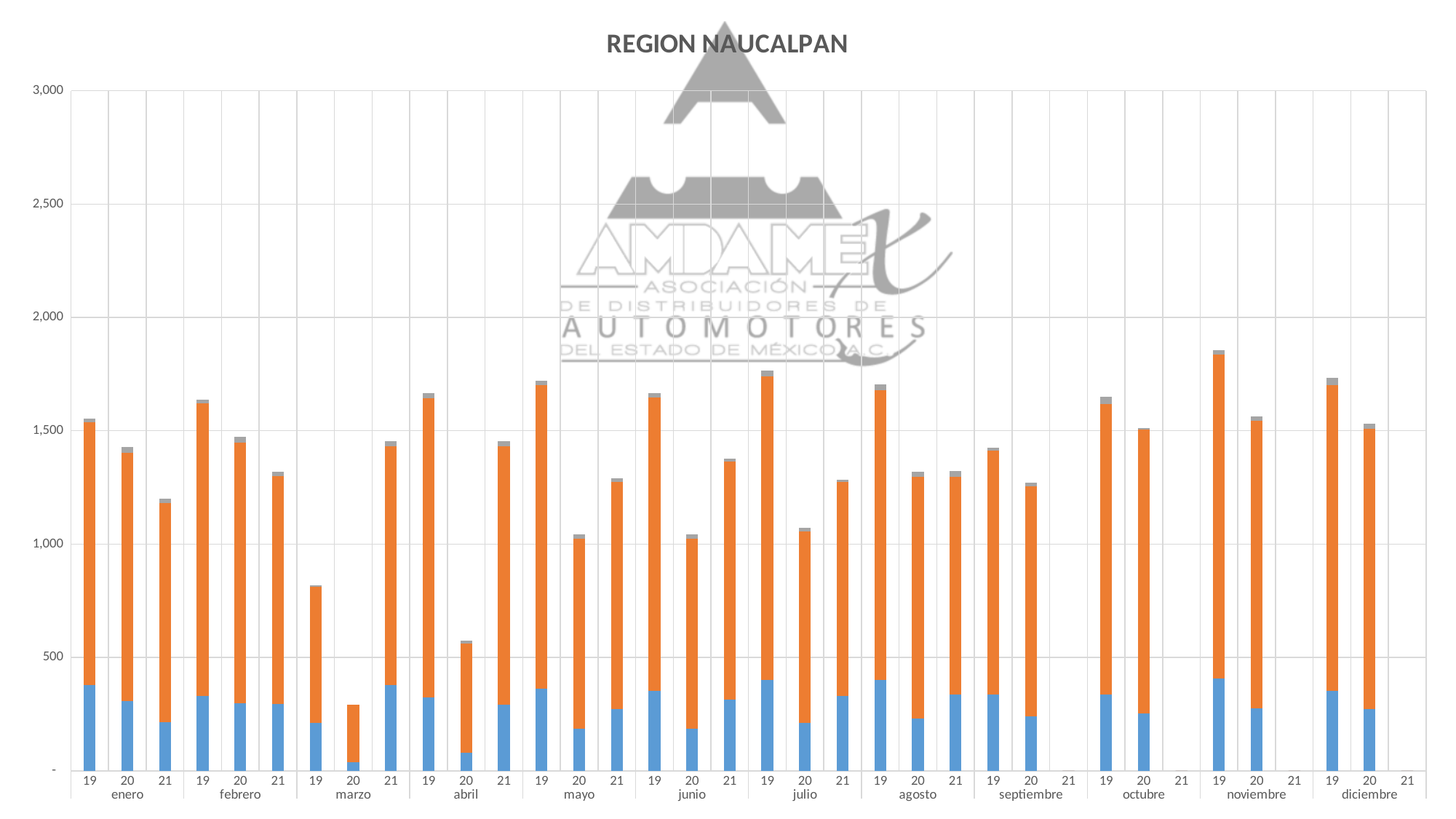
Is the total for marzo 20 greater or less than 500? less Which month and year has the tallest bar in the chart? noviembre 19 Is the total for noviembre 19 greater or less than 1,500? greater Which month and year has the shortest bar in the chart? marzo 20 What kind of chart is shown on the slide? stacked bar chart How many months are shown along the x axis? 12 Is the total for abril 20 greater or less than 1,000? less Which bar is taller, abril 20 or abril 21? abril 21 In enero, do the bar totals rise or fall from 19 to 21? fall Which bar is taller, enero 19 or enero 21? enero 19 What is the title of the chart? REGION NAUCALPAN